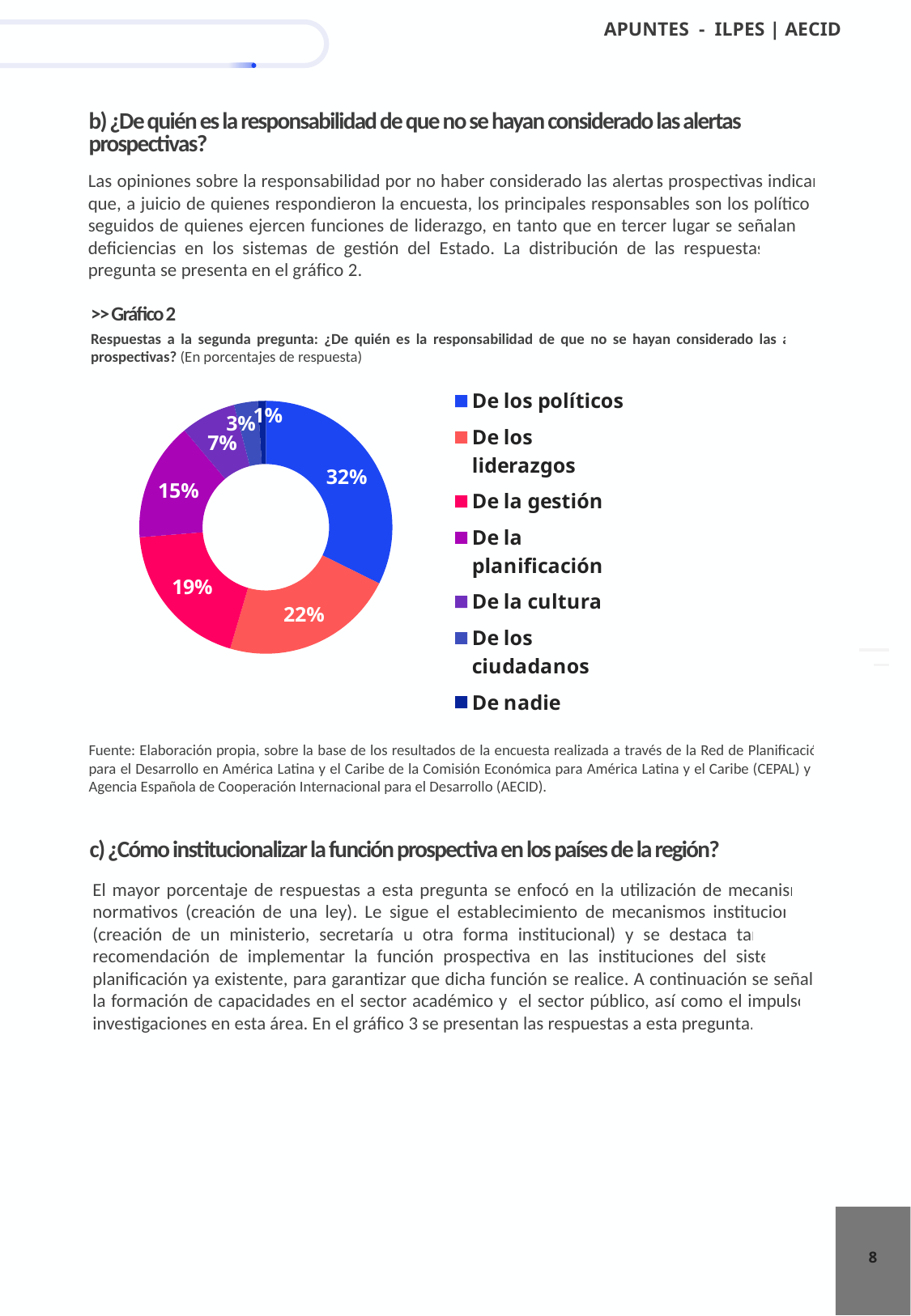
What kind of chart is shown in Gráfico 2? Pie chart (donut) How many categories does the legend of Gráfico 2 list? 7 What colour is the slice for 'De los políticos'? Blue Which category has the smallest share of responses? De nadie What percentage of responses correspond to 'De la planificación'? 15% What percentage of responses correspond to 'De la cultura'? 7% What is the difference in percentage points between 'De los políticos' and 'De los liderazgos'? 10 percentage points What percentage of responses correspond to 'De los liderazgos'? 22% What percentage of responses attribute responsibility to 'De los políticos'? 32% Which is larger, the share for 'De la gestión' or the share for 'De la planificación'? De la gestión What percentage of responses correspond to 'De la gestión'? 19% Which category has the largest share of responses? De los políticos